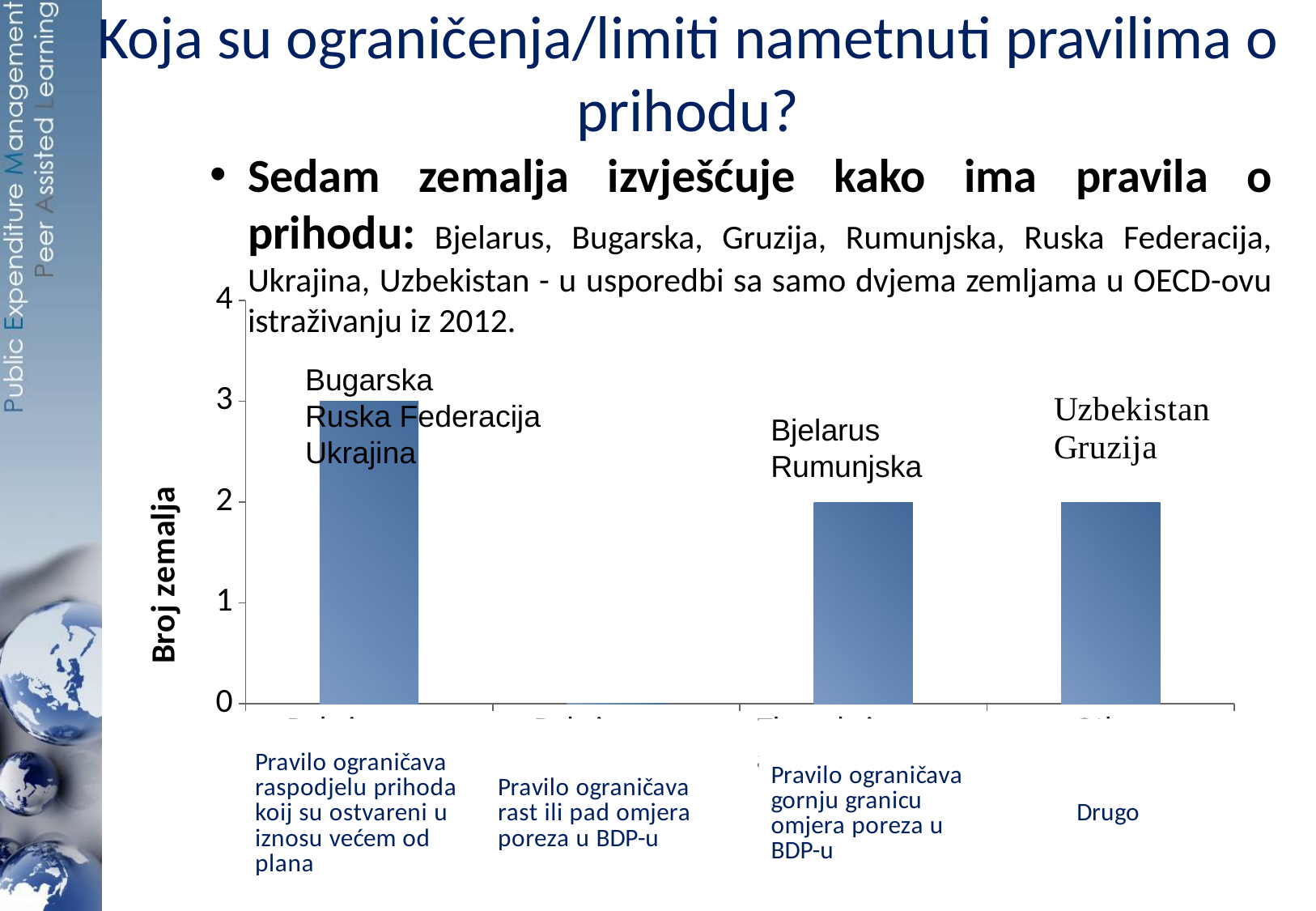
What is the label of the y axis of the chart? Broj zemalja What type of chart is shown on the slide? bar chart What is the value for the category 'Pravilo ograničava raspodjelu prihoda koij su ostvareni u iznosu većem od plana'? 3 What is the value for the category 'Drugo'? 2 What is the value for the category 'Pravilo ograničava rast ili pad omjera poreza u BDP-u'? 0 Which countries are listed above the bar for 'Drugo'? Uzbekistan, Gruzija Which is larger: the value for 'Pravilo ograničava raspodjelu prihoda koij su ostvareni u iznosu većem od plana' or the value for 'Pravilo ograničava gornju granicu omjera poreza u BDP-u'? Pravilo ograničava raspodjelu prihoda koij su ostvareni u iznosu većem od plana Which category has the lowest value? Pravilo ograničava rast ili pad omjera poreza u BDP-u How many categories are shown on the x axis of the chart? 4 Which category has the highest value? Pravilo ograničava raspodjelu prihoda koij su ostvareni u iznosu većem od plana What is the value for the category 'Pravilo ograničava gornju granicu omjera poreza u BDP-u'? 2 What is the difference between the value for 'Pravilo ograničava raspodjelu prihoda koij su ostvareni u iznosu većem od plana' and the value for 'Drugo'? 1